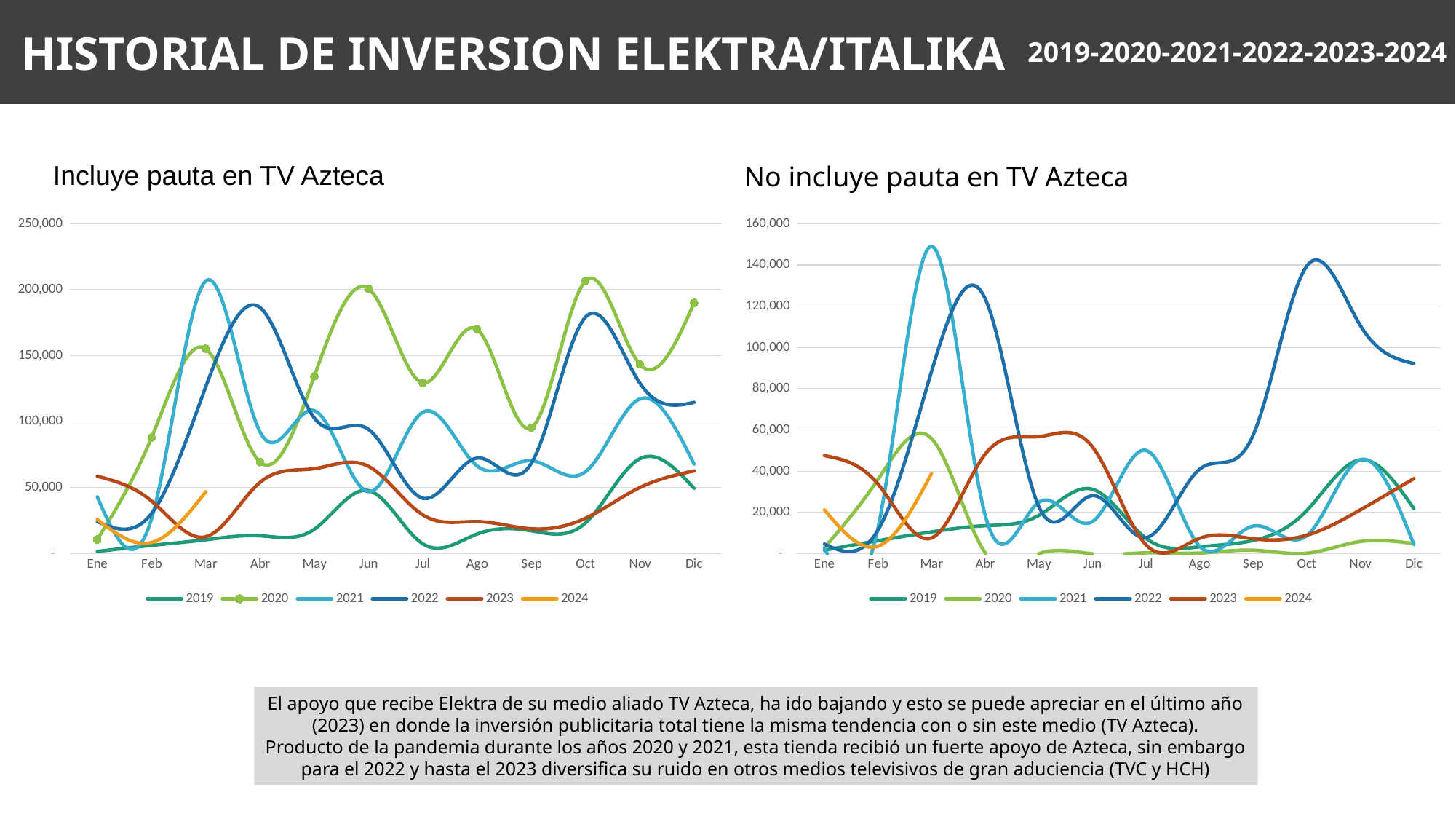
In the chart 'Incluye pauta en TV Azteca', is the value for 2019 in Jul greater or less than 50,000? less In the chart 'No incluye pauta en TV Azteca', is the value for 2023 in Jun greater or less than 80,000? less In the chart 'No incluye pauta en TV Azteca', in which month does the 2022 series reach its highest value? Oct How many series does the legend of the chart 'No incluye pauta en TV Azteca' list? 6 What kind of chart is the chart titled 'Incluye pauta en TV Azteca'? line chart In the chart 'Incluye pauta en TV Azteca', which is larger in Mar: the value for 2021 or the value for 2023? 2021 In the chart 'No incluye pauta en TV Azteca', does the 2022 series rise or fall from Oct to Dic? fall In the chart 'Incluye pauta en TV Azteca', in which month does the 2021 series reach its highest value? Mar In the chart 'No incluye pauta en TV Azteca', is the value for 2021 in Mar greater or less than 140,000? greater How many months are shown on the x axis of the chart 'Incluye pauta en TV Azteca'? 12 What is the title of the chart on the right side of the slide? No incluye pauta en TV Azteca